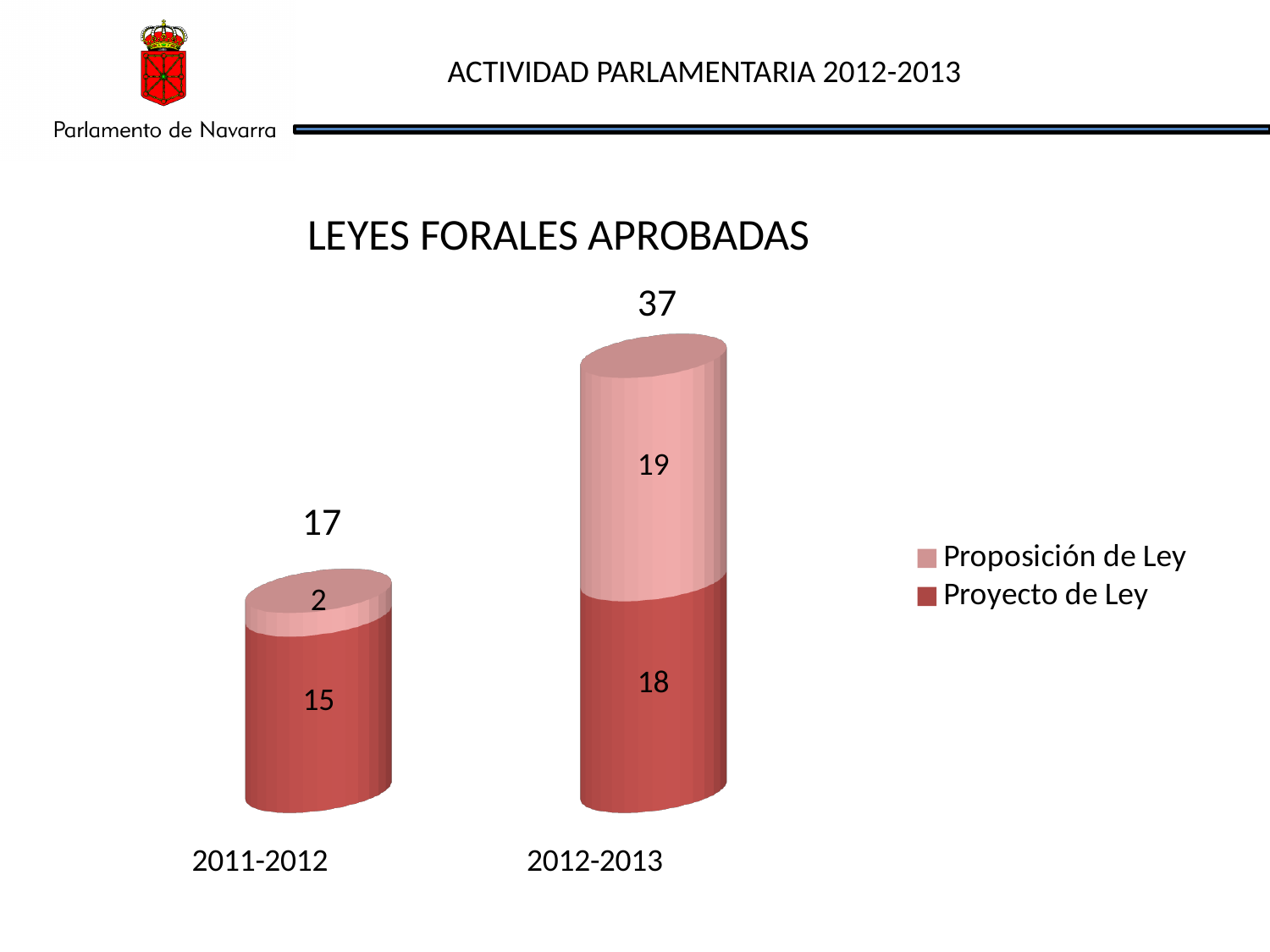
What is the title of the chart? LEYES FORALES APROBADAS Which period has the highest total of leyes forales aprobadas? 2012-2013 What kind of chart is shown? Stacked bar chart What is the total of the stacked bar for 2011-2012? 17 What is the value for Proyecto de Ley in 2011-2012? 15 What is the value for Proposición de Ley in 2011-2012? 2 What is the total of the stacked bar for 2012-2013? 37 Which is larger: Proposición de Ley in 2012-2013 or Proposición de Ley in 2011-2012? Proposición de Ley in 2012-2013 What is the difference between the totals for 2012-2013 and 2011-2012? 20 What is the value for Proyecto de Ley in 2012-2013? 18 What is the value for Proposición de Ley in 2012-2013? 19 How many series does the legend list? 2